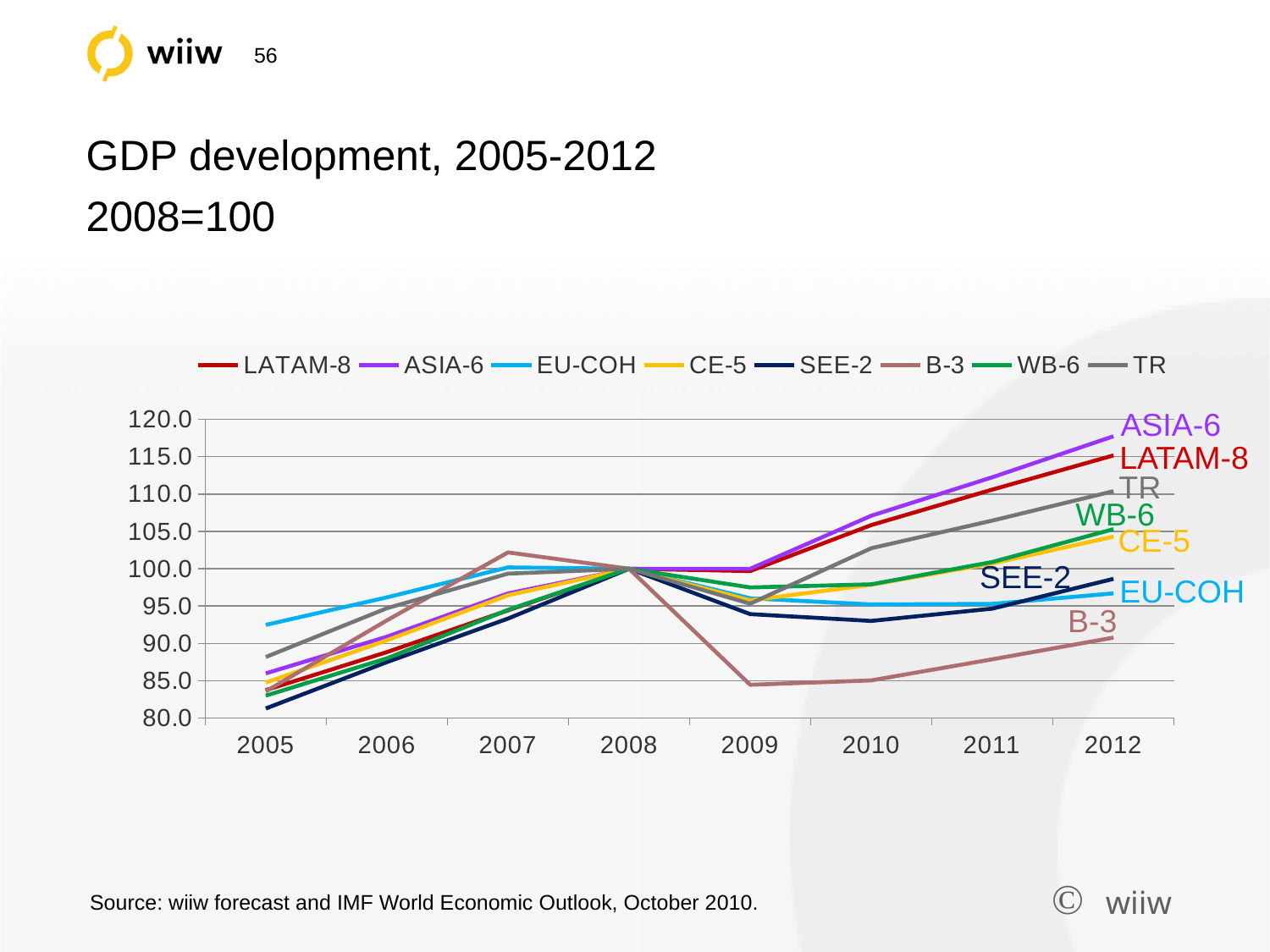
Which series has the lowest value in 2012? B-3 Is the value for EU-COH in 2012 greater or less than 100? less Which series has the lowest value in 2005? SEE-2 Which is larger in 2012, the value for ASIA-6 or the value for B-3? ASIA-6 Which series has the highest value in 2012? ASIA-6 Does the B-3 line rise or fall from 2009 to 2012? rise What kind of chart is shown on the slide? Line chart How many series does the legend list? 8 How many years are shown on the x axis? 8 What is the value of every series in 2008? 100.0 Is the value for B-3 in 2009 greater or less than 90? less Is the value for ASIA-6 in 2012 greater or less than 115? greater